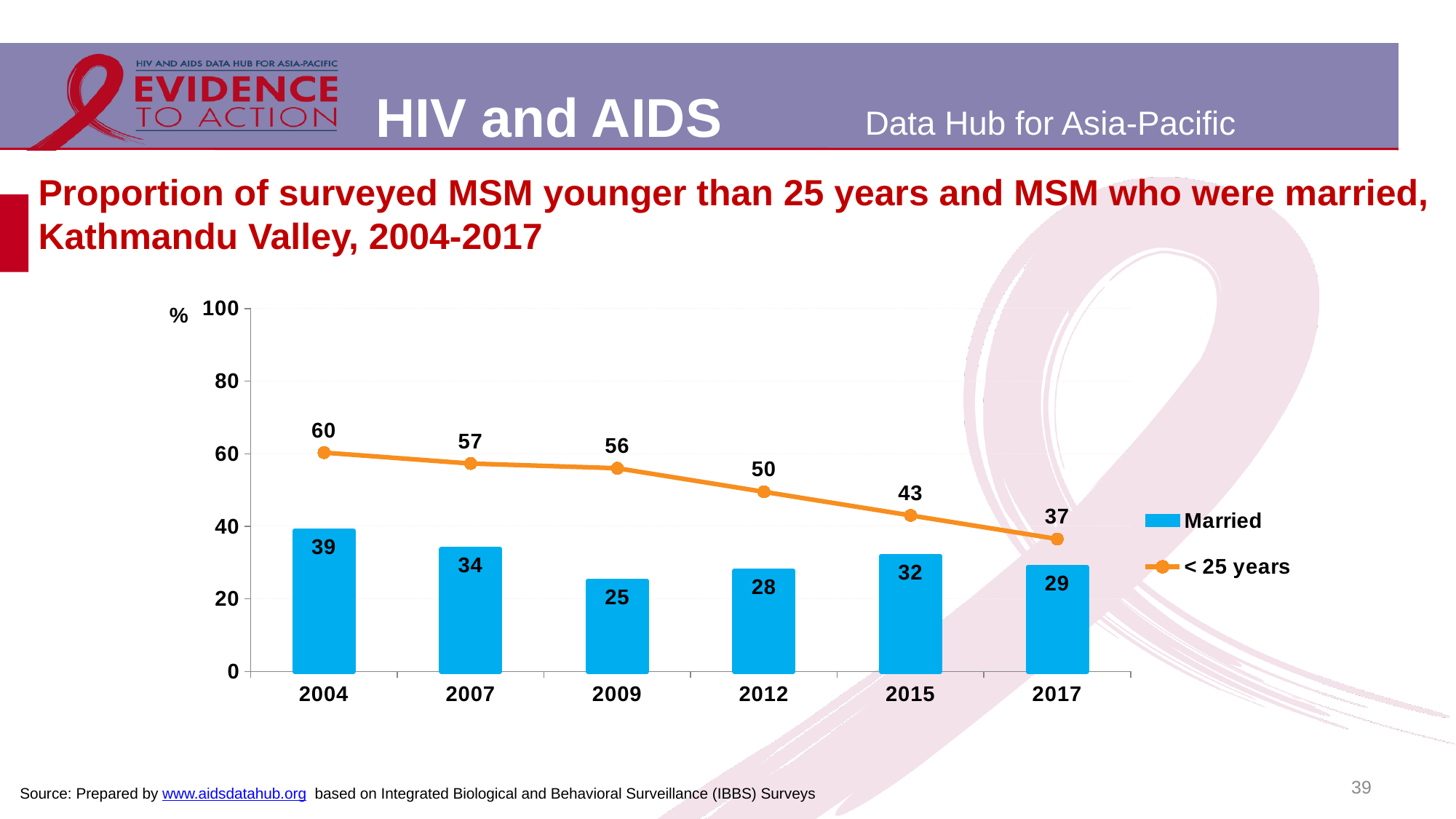
Does the < 25 years series rise or fall from 2004 to 2017? fall What is the value for Married in 2017? 29 Which is larger in 2017, the Married value or the < 25 years value? < 25 years What is the difference between the < 25 years value and the Married value in 2015? 11 What is the value for Married in 2004? 39 Which series is drawn as a line with markers? < 25 years In which year is the Married series lowest? 2009 How many years are shown on the x axis? 6 In which year is the < 25 years series highest? 2004 How many series does the legend list? 2 What is the value for < 25 years in 2012? 50 Is the value for < 25 years in 2009 greater or less than 40? greater